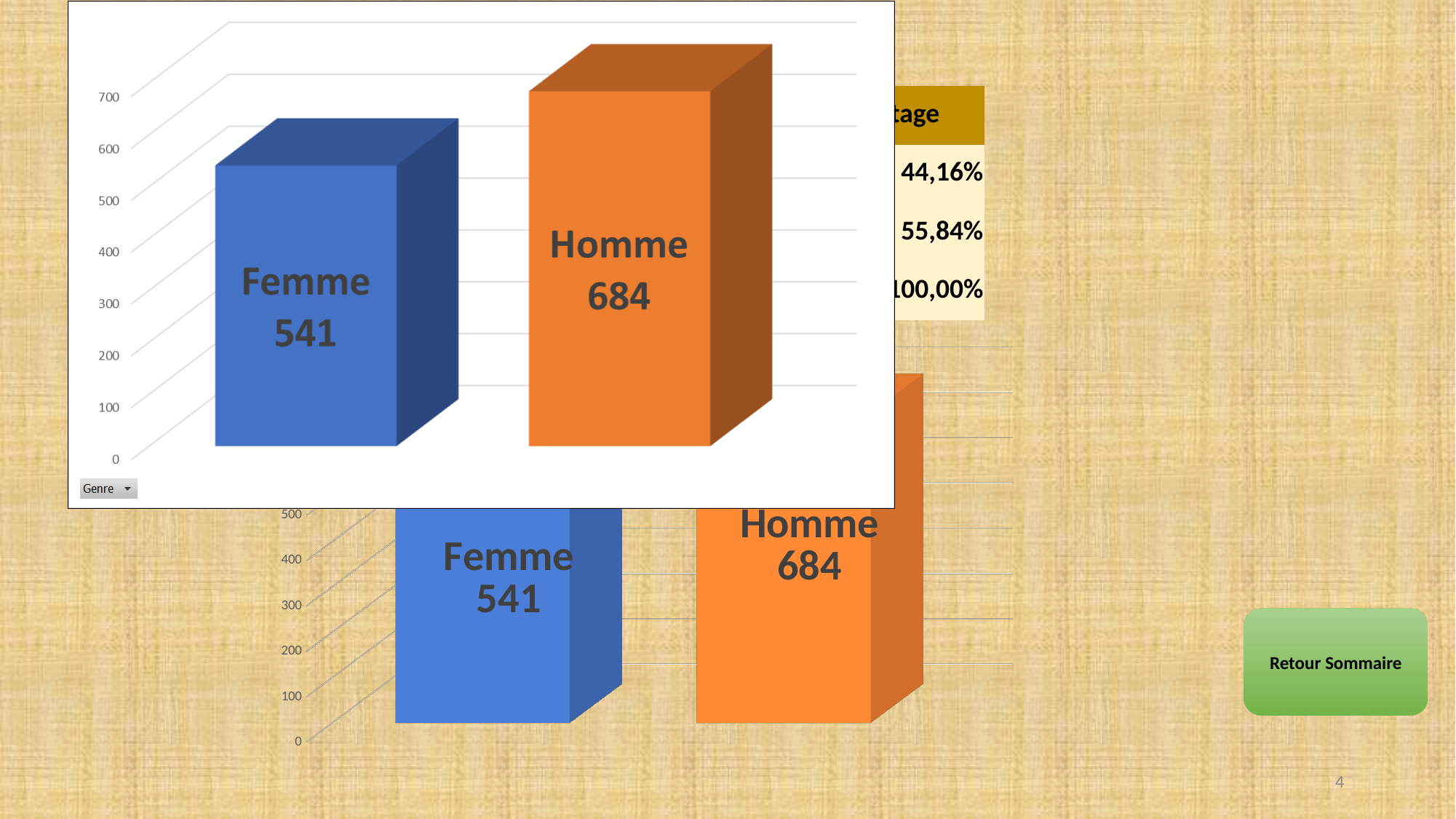
In the top-left chart, which category has the highest value? Homme In the top-left chart, how many categories are plotted? 2 In the top-left chart, is the value for Femme greater or less than 600? less In the top-left chart, what is the difference between the values for Homme and Femme? 143 What kind of chart is the top-left chart? bar chart In the top-left chart, which category has the lowest value? Femme In the bottom chart, what is the value for Homme? 684 In the top-left chart, what colour is the bar for Femme? blue In the top-left chart, what is the value for Homme? 684 In the top-left chart, is the value for Homme greater or less than 600? greater In the bottom chart, which is larger, the value for Femme or the value for Homme? Homme In the top-left chart, what is the value for Femme? 541